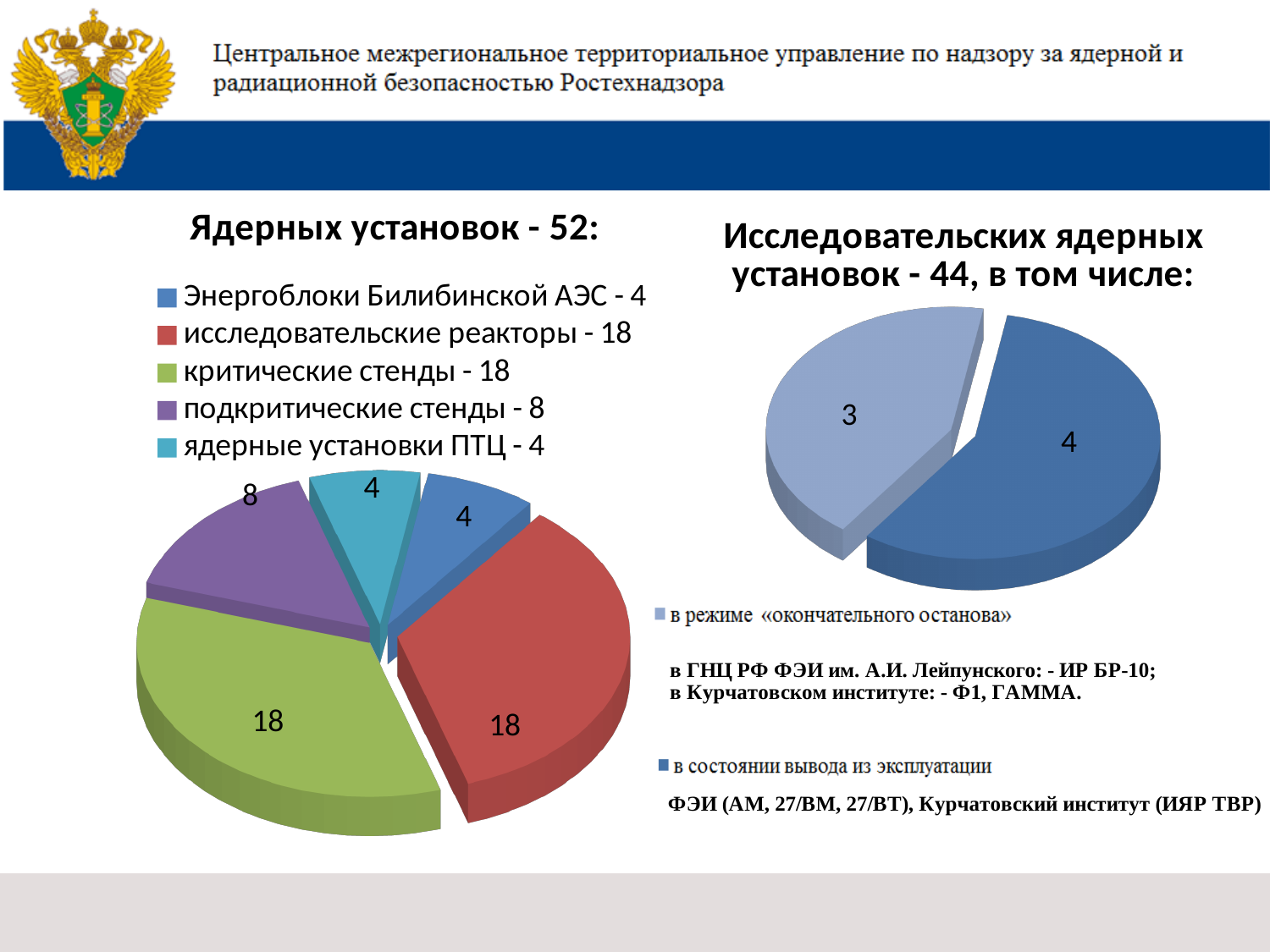
In the right chart "Исследовательских ядерных установок - 44, в том числе:", which category has the largest slice? в состоянии вывода из эксплуатации What kind of chart is the left chart titled "Ядерных установок - 52:"? pie chart In the left chart "Ядерных установок - 52:", what is the value for критические стенды? 18 In the right chart "Исследовательских ядерных установок - 44, в том числе:", what is the difference between в состоянии вывода из эксплуатации and в режиме «окончательного останова»? 1 In the right chart "Исследовательских ядерных установок - 44, в том числе:", what is the value for в режиме «окончательного останова»? 3 In the left chart "Ядерных установок - 52:", what is the total of all slices? 52 In the left chart "Ядерных установок - 52:", what colour is the slice for критические стенды? green In the right chart "Исследовательских ядерных установок - 44, в том числе:", how many slices does the pie have? 2 In the left chart "Ядерных установок - 52:", which is larger: подкритические стенды or ядерные установки ПТЦ? подкритические стенды In the left chart "Ядерных установок - 52:", what is the value for подкритические стенды? 8 In the left chart "Ядерных установок - 52:", how many slices does the pie have? 5 In the left chart "Ядерных установок - 52:", what is the difference between исследовательские реакторы and подкритические стенды? 10